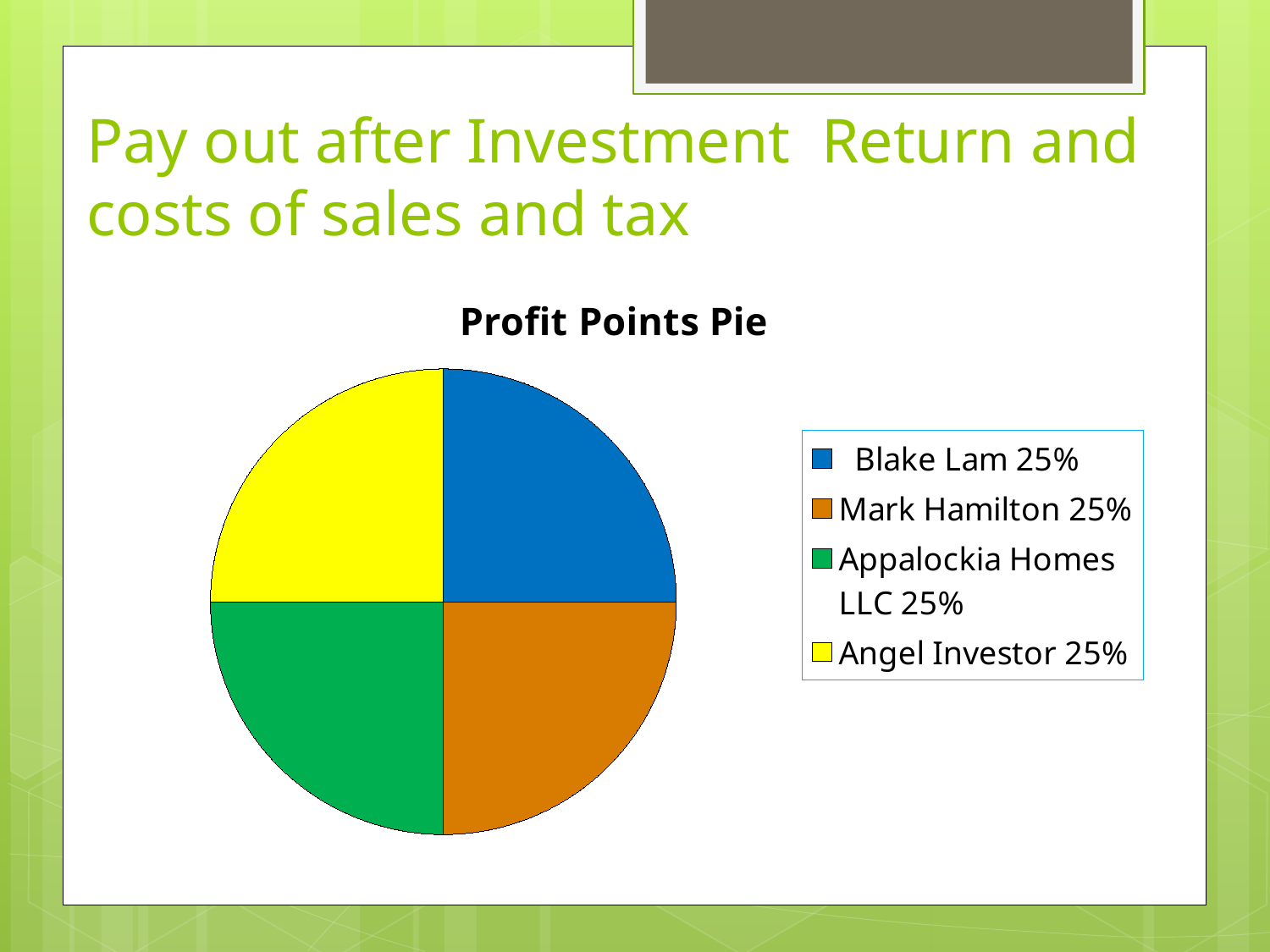
What share of the pie does Angel Investor hold? 25% Which colour represents Angel Investor in the pie chart? yellow What is the title of the chart? Profit Points Pie What share of the pie does Appalockia Homes LLC hold? 25% What is the combined share of Blake Lam and Mark Hamilton? 50% What kind of chart is shown on the slide? pie chart What share of the pie does Mark Hamilton hold? 25% Is the share for Mark Hamilton greater or less than 50%? less How many slices does the pie chart have? 4 What is the difference between the shares of Blake Lam and Angel Investor? 0%